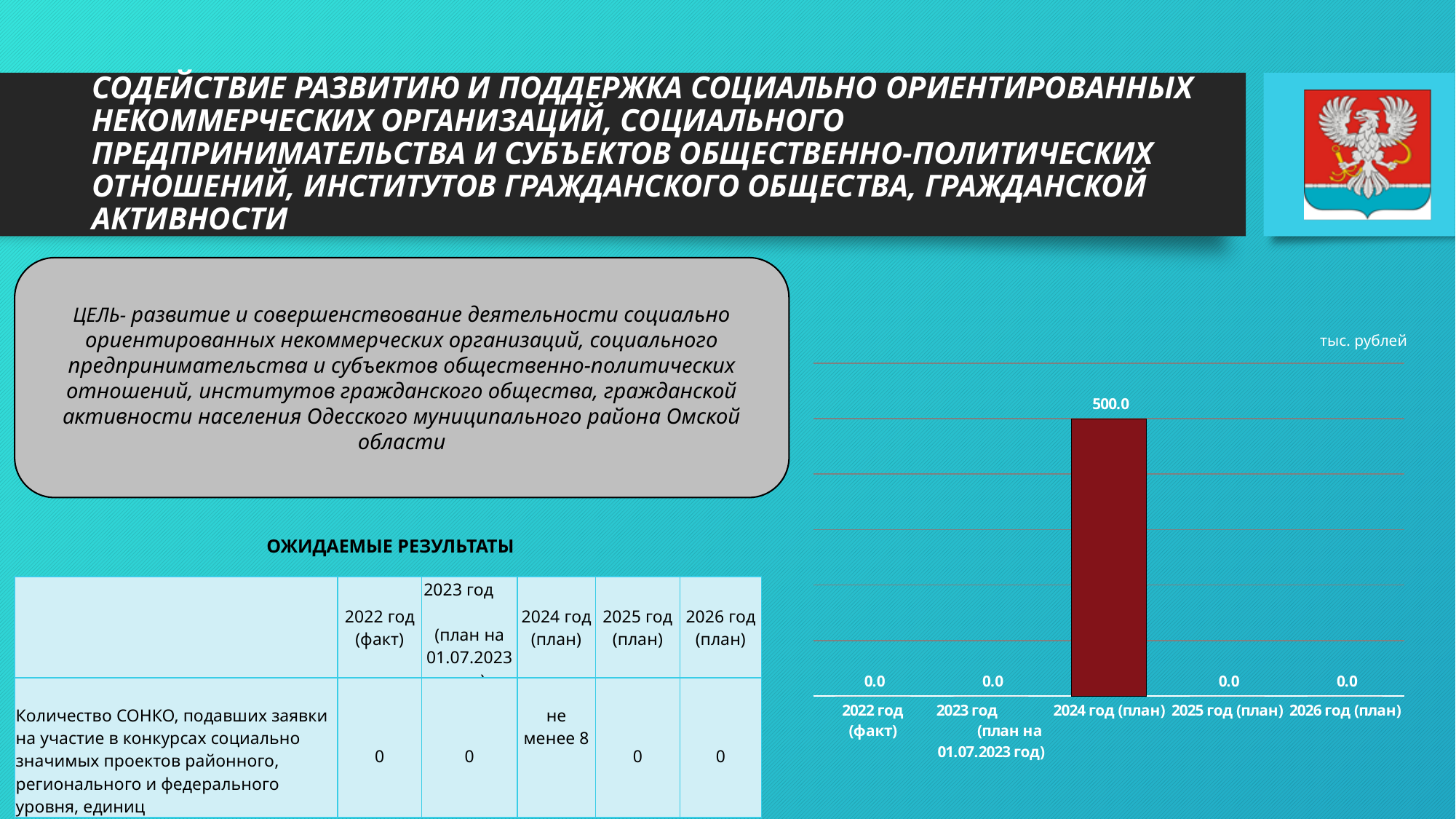
Which is larger on the bar chart: the value for 2024 год (план) or the value for 2022 год (факт)? 2024 год (план) What is the value for 2024 год (план) on the bar chart? 500.0 How many categories (years) are plotted on the bar chart? 5 What is the difference between the values for 2024 год (план) and 2025 год (план) on the bar chart? 500.0 What is the value for 2026 год (план) on the bar chart? 0.0 What type of chart is shown on the right side of the slide? bar chart What is the value for 2025 год (план) on the bar chart? 0.0 What unit of measurement is indicated above the bar chart? тыс. рублей What is the value for 2023 год (план на 01.07.2023 год) on the bar chart? 0.0 Which category has the highest value on the bar chart? 2024 год (план) What is the value for 2022 год (факт) on the bar chart? 0.0 What colour is the bar for 2024 год (план) on the chart? dark red